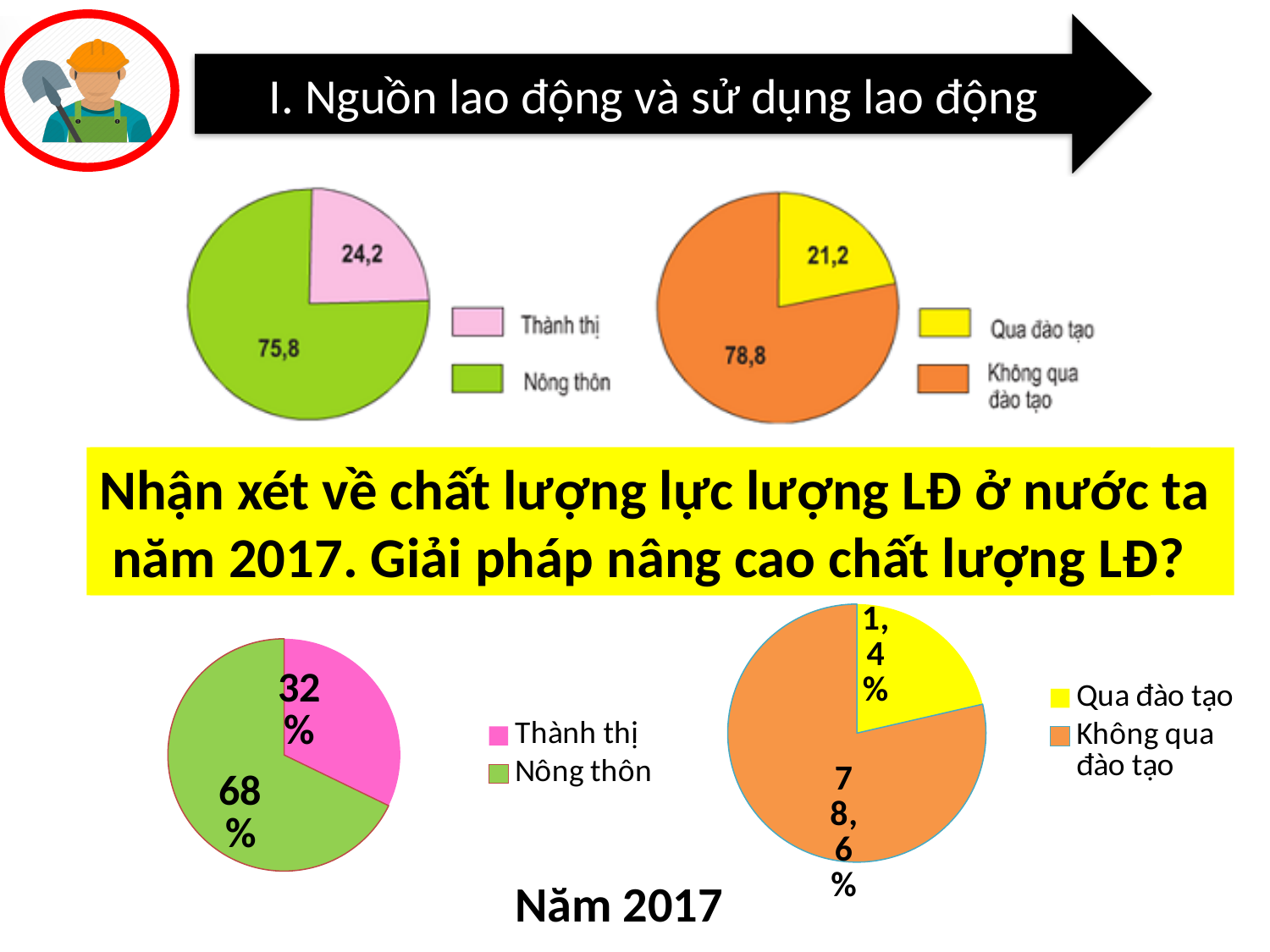
In the top-left pie chart, what is the value for Thành thị? 24,2 In the top-right pie chart, what is the value for Qua đào tạo? 21,2 In the top-left pie chart, which category has the largest slice? Nông thôn In the top-left pie chart, what is the value for Nông thôn? 75,8 In the top-right pie chart, which category has the smallest slice? Qua đào tạo What type of chart is the bottom-left chart on the slide? Pie chart How many entries does the legend of the bottom-right pie chart list? 2 In the bottom-left pie chart (Năm 2017), what is the value for Nông thôn? 68% In the bottom-left pie chart (Năm 2017), what is the value for Thành thị? 32% In the top-right pie chart, what is the value for Không qua đào tạo? 78,8 In the bottom-right pie chart (Năm 2017), what is the value for Không qua đào tạo? 78,6% In the bottom-left pie chart (Năm 2017), what is the difference between Nông thôn and Thành thị? 36%